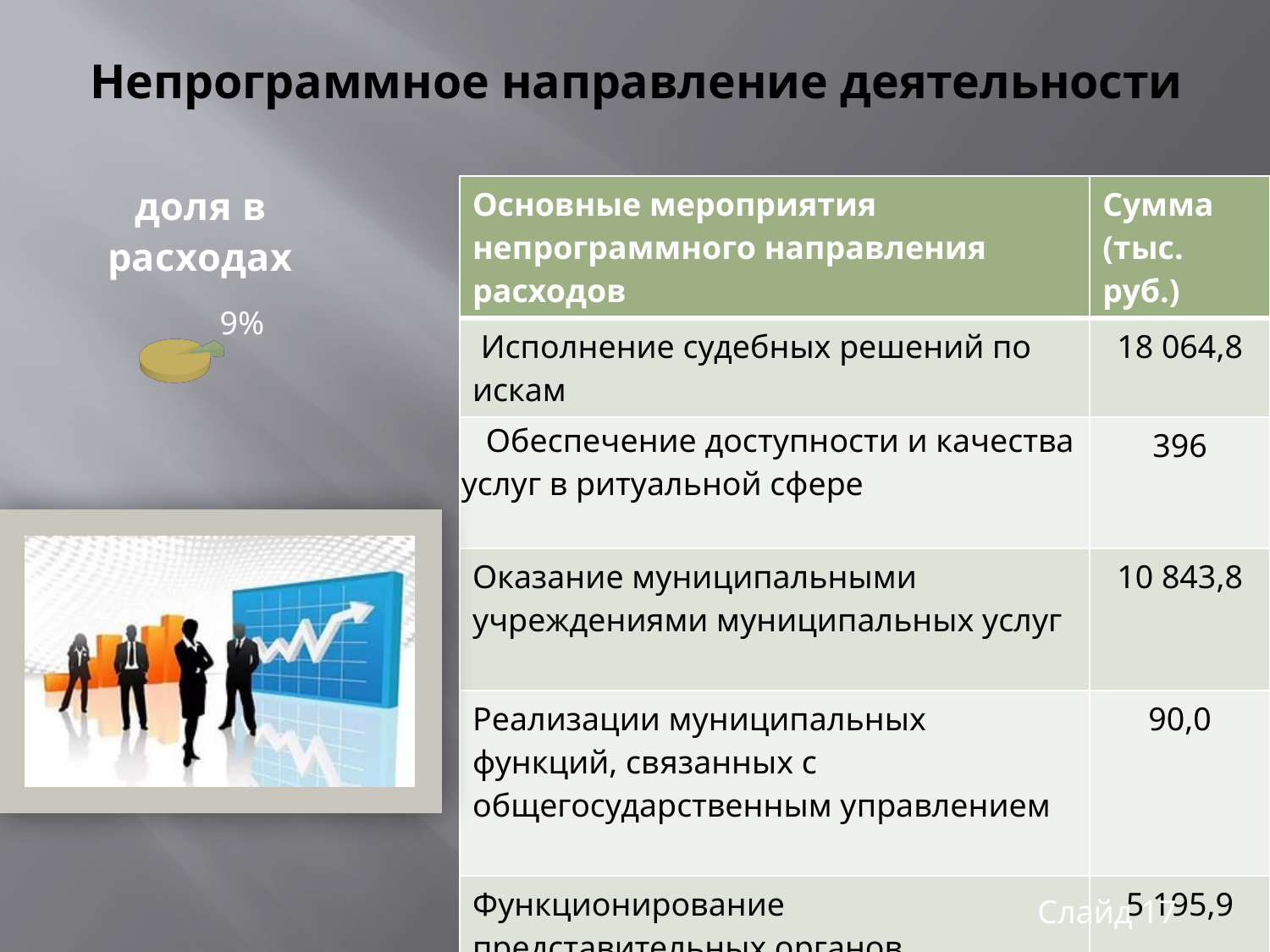
What percentage is printed as the data label on the pie chart? 9% What share of the pie does the labelled (pulled-out) slice represent? 9% Is the labelled slice of the pie chart greater or less than 50% of the pie? less What kind of chart is shown under the heading "доля в расходах"? pie chart What is the title of the pie chart on the left of the slide? доля в расходах